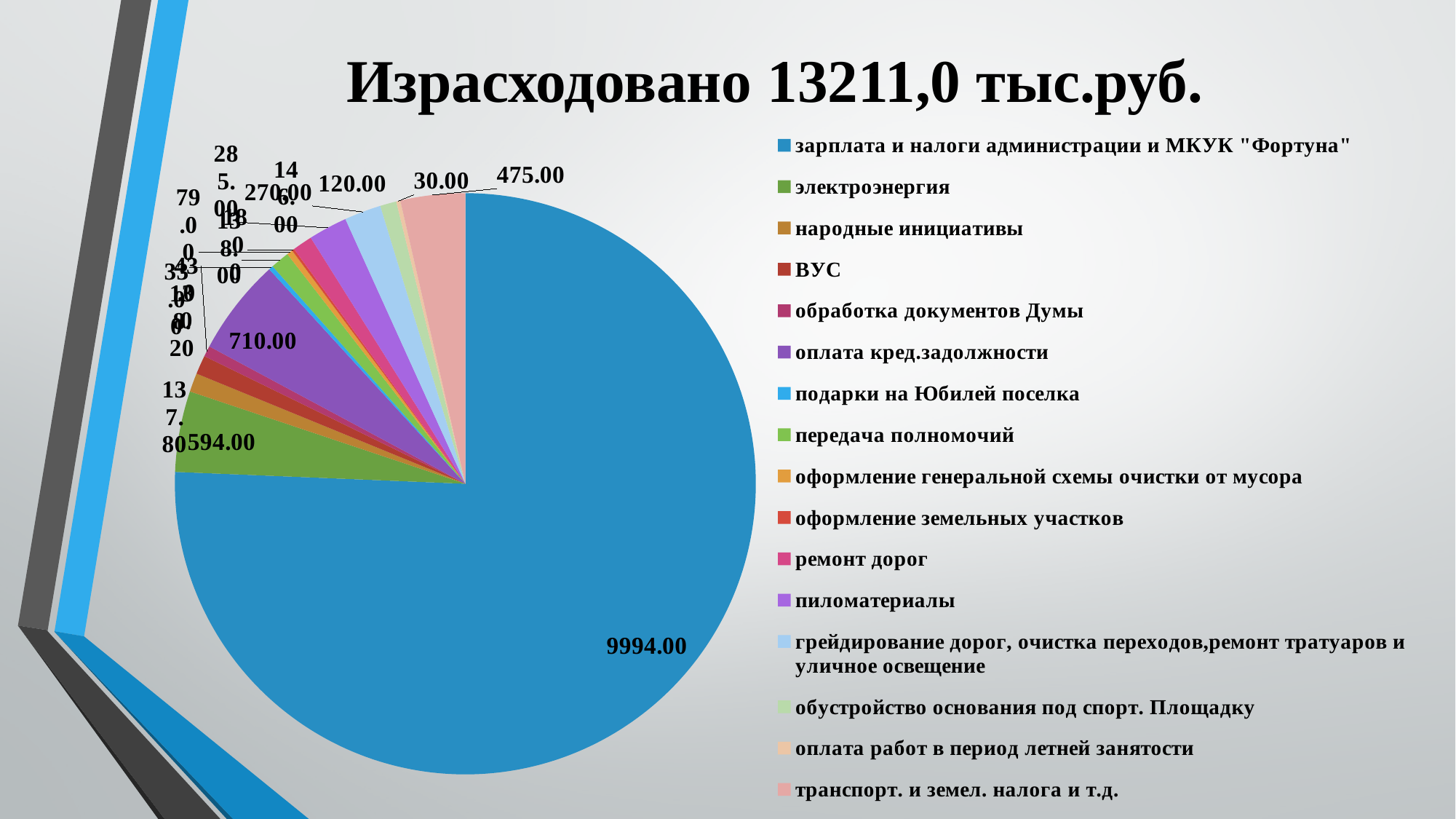
Which is larger, the value for "электроэнергия" or the value for "оплата кред.задолжности"? оплата кред.задолжности How many categories does the legend of the pie chart list? 16 What kind of chart is shown on the slide? pie chart What is the value for "электроэнергия" in the pie chart? 594.00 What is the value for "оплата кред.задолжности" in the pie chart? 710.00 What is the value for "зарплата и налоги администрации и МКУК "Фортуна"" in the pie chart? 9994.00 What is the value for "транспорт. и земел. налога и т.д." in the pie chart? 475.00 Which category has the largest slice in the pie chart? зарплата и налоги администрации и МКУК "Фортуна" What is the difference between the values for "зарплата и налоги администрации и МКУК "Фортуна"" and "оплата кред.задолжности"? 9284.00 What is the difference between the values for "оплата кред.задолжности" and "электроэнергия"? 116.00 What colour is the largest slice of the pie chart? blue What is the title of the slide above the pie chart? Израсходовано 13211,0 тыс.руб.